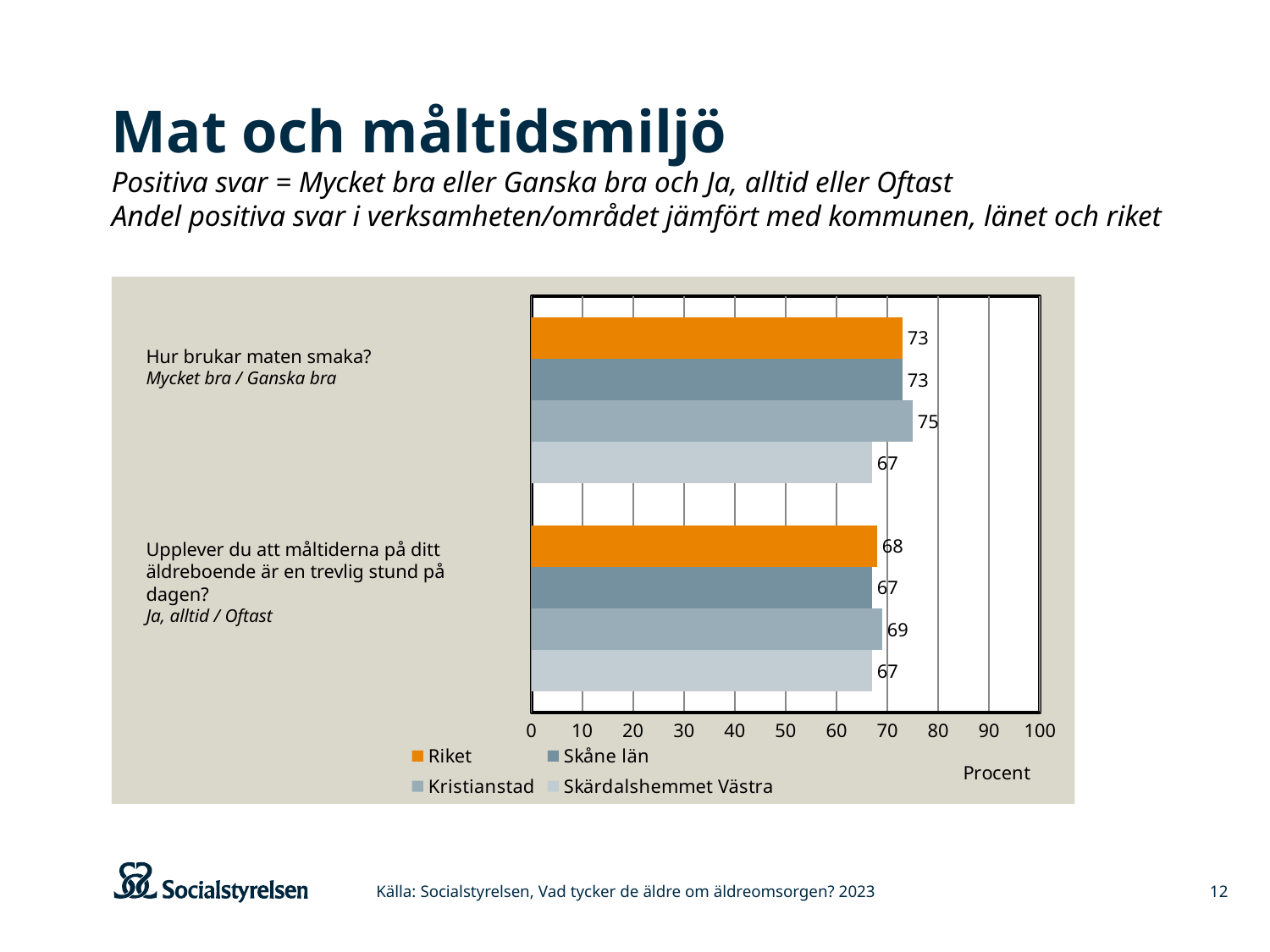
What is the value for Skärdalshemmet Västra for "Hur brukar maten smaka?"? 67 How many series does the legend list? 4 Is the value for Kristianstad for "Upplever du att måltiderna på ditt äldreboende är en trevlig stund på dagen?" greater or less than 60? greater Which series has the lowest value for "Hur brukar maten smaka?"? Skärdalshemmet Västra What is the difference between the Kristianstad and Skärdalshemmet Västra values for "Hur brukar maten smaka?"? 8 What is the value for Kristianstad for "Hur brukar maten smaka?"? 75 How many question categories are plotted on the chart? 2 What is the value for Skåne län for "Upplever du att måltiderna på ditt äldreboende är en trevlig stund på dagen?"? 67 What unit is shown on the x axis label? Procent Which series has the highest value for "Hur brukar maten smaka?"? Kristianstad What is the value for Riket for "Upplever du att måltiderna på ditt äldreboende är en trevlig stund på dagen?"? 68 What type of chart is shown on the slide? bar chart